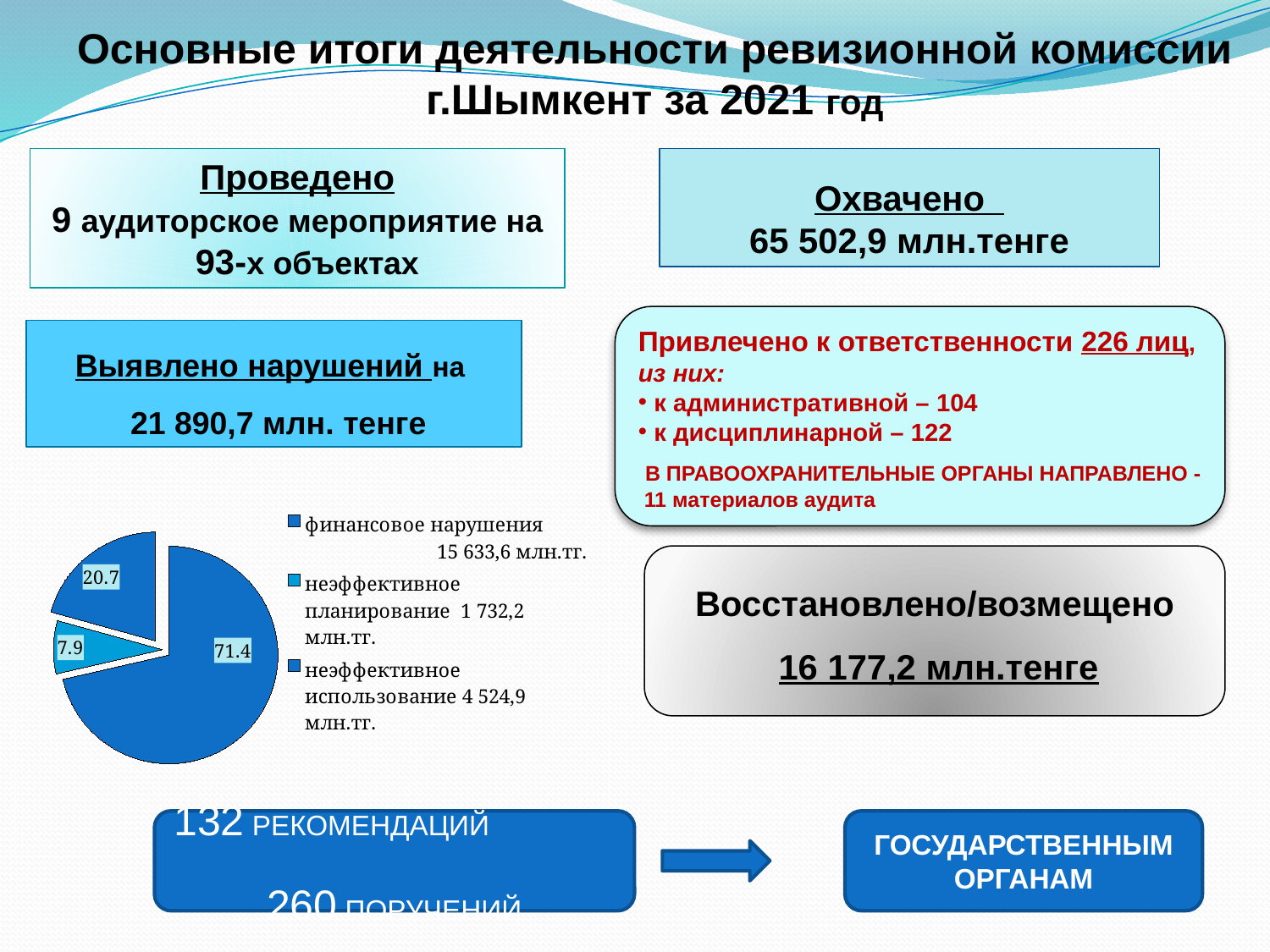
What amount is given in the legend for 'финансовое нарушения'? 15 633,6 млн.тг. What amount is given in the legend for 'неэффективное планирование'? 1 732,2 млн.тг. What amount is given in the legend for 'неэффективное использование'? 4 524,9 млн.тг. How many slices does the pie chart have? 3 Which has the larger amount in the legend: 'неэффективное планирование' or 'неэффективное использование'? неэффективное использование What percentage label is shown on the largest slice of the pie chart? 71.4 Which legend category corresponds to the largest slice of the pie chart? финансовое нарушения What is the smallest value labelled on the pie chart? 7.9 What is the difference between the two largest percentage labels on the pie chart (71.4 and 20.7)? 50.7 What is the largest value labelled on the pie chart? 71.4 What type of chart is shown on the slide? pie chart How many entries does the legend of the pie chart list? 3